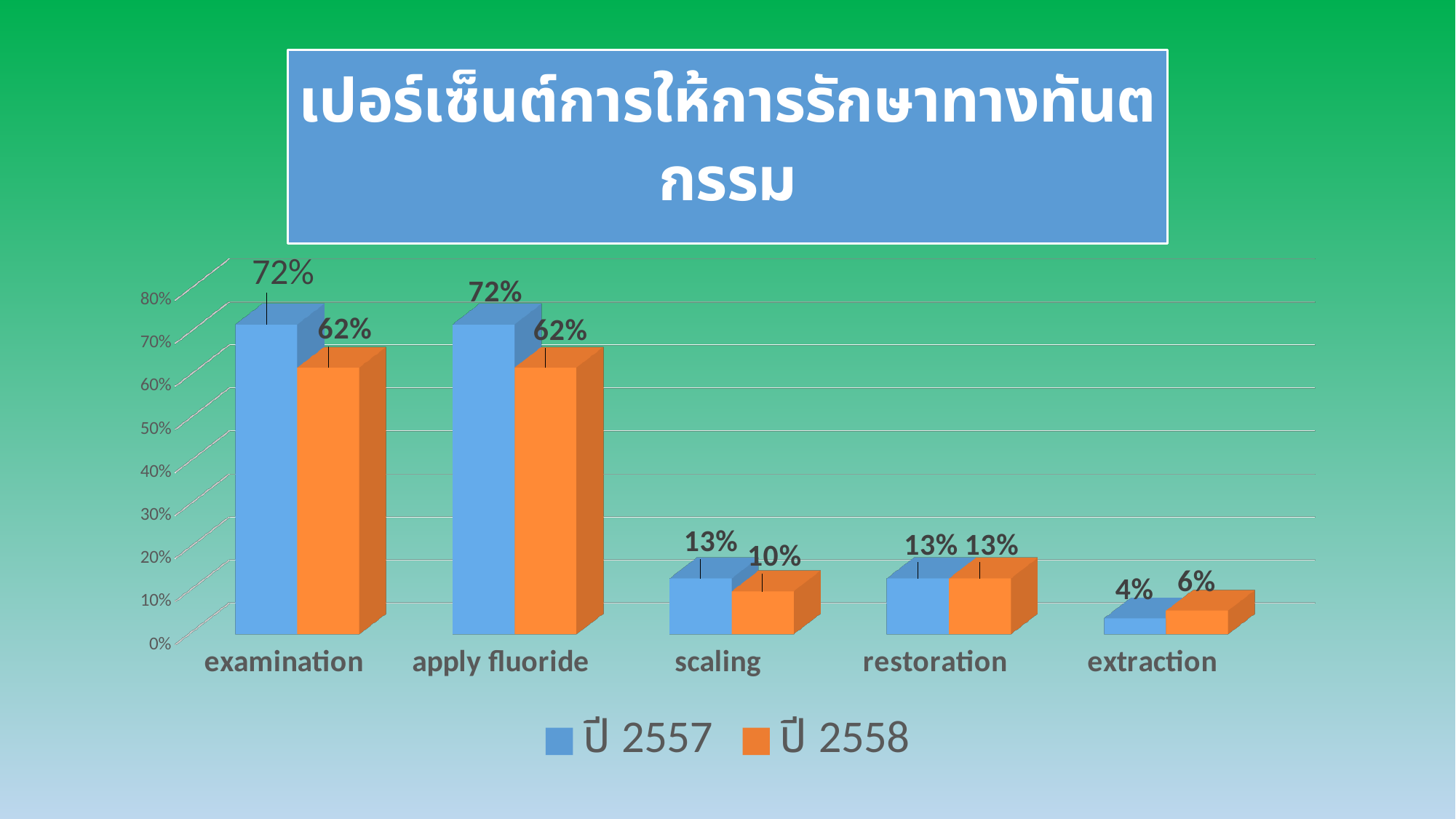
What is the value for extraction in the ปี 2557 series? 4% What is the value for scaling in the ปี 2558 series? 10% Which is larger for extraction: the ปี 2557 value or the ปี 2558 value? ปี 2558 Which is larger for scaling: the ปี 2557 value or the ปี 2558 value? ปี 2557 How many series does the legend list? 2 What is the difference between the ปี 2557 and ปี 2558 values for apply fluoride? 10% What is the value for examination in the ปี 2557 series? 72% Which colour represents the ปี 2558 series? orange How many categories are shown on the x axis? 5 What is the value for restoration in the ปี 2558 series? 13% What kind of chart is shown on the slide? bar chart Which category has the lowest value in the ปี 2558 series? extraction